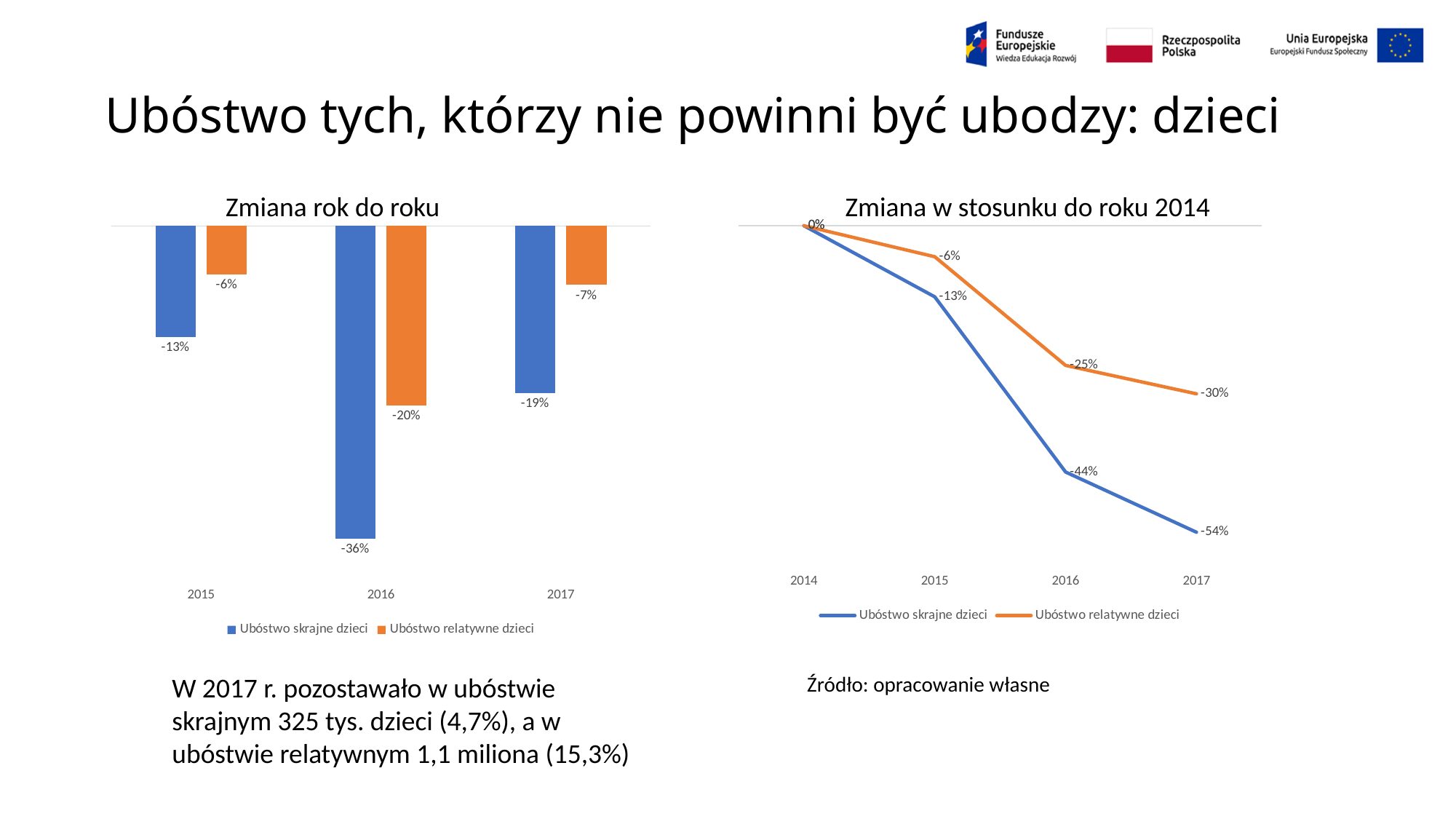
In the chart 'Zmiana rok do roku', how many years are shown on the x axis? 3 In the chart 'Zmiana w stosunku do roku 2014', which colour is the line for Ubóstwo relatywne dzieci? Orange In the chart 'Zmiana w stosunku do roku 2014', what is the value for Ubóstwo skrajne dzieci in 2017? -54% In the chart 'Zmiana rok do roku', what is the value for Ubóstwo relatywne dzieci in 2017? -7% In the chart 'Zmiana w stosunku do roku 2014', how many series does the legend list? 2 In the chart 'Zmiana w stosunku do roku 2014', what is the difference between Ubóstwo skrajne dzieci and Ubóstwo relatywne dzieci in 2017? 24 percentage points What type of chart is 'Zmiana rok do roku'? Bar chart In the chart 'Zmiana rok do roku', what is the difference between the Ubóstwo skrajne dzieci and Ubóstwo relatywne dzieci values in 2015? 7 percentage points In the chart 'Zmiana w stosunku do roku 2014', do the values for Ubóstwo skrajne dzieci rise or fall from 2014 to 2017? Fall In the chart 'Zmiana rok do roku', what is the value for Ubóstwo skrajne dzieci in 2016? -36% In the chart 'Zmiana w stosunku do roku 2014', what is the value for Ubóstwo relatywne dzieci in 2016? -25% In the chart 'Zmiana rok do roku', in which year does Ubóstwo skrajne dzieci have the largest decline? 2016